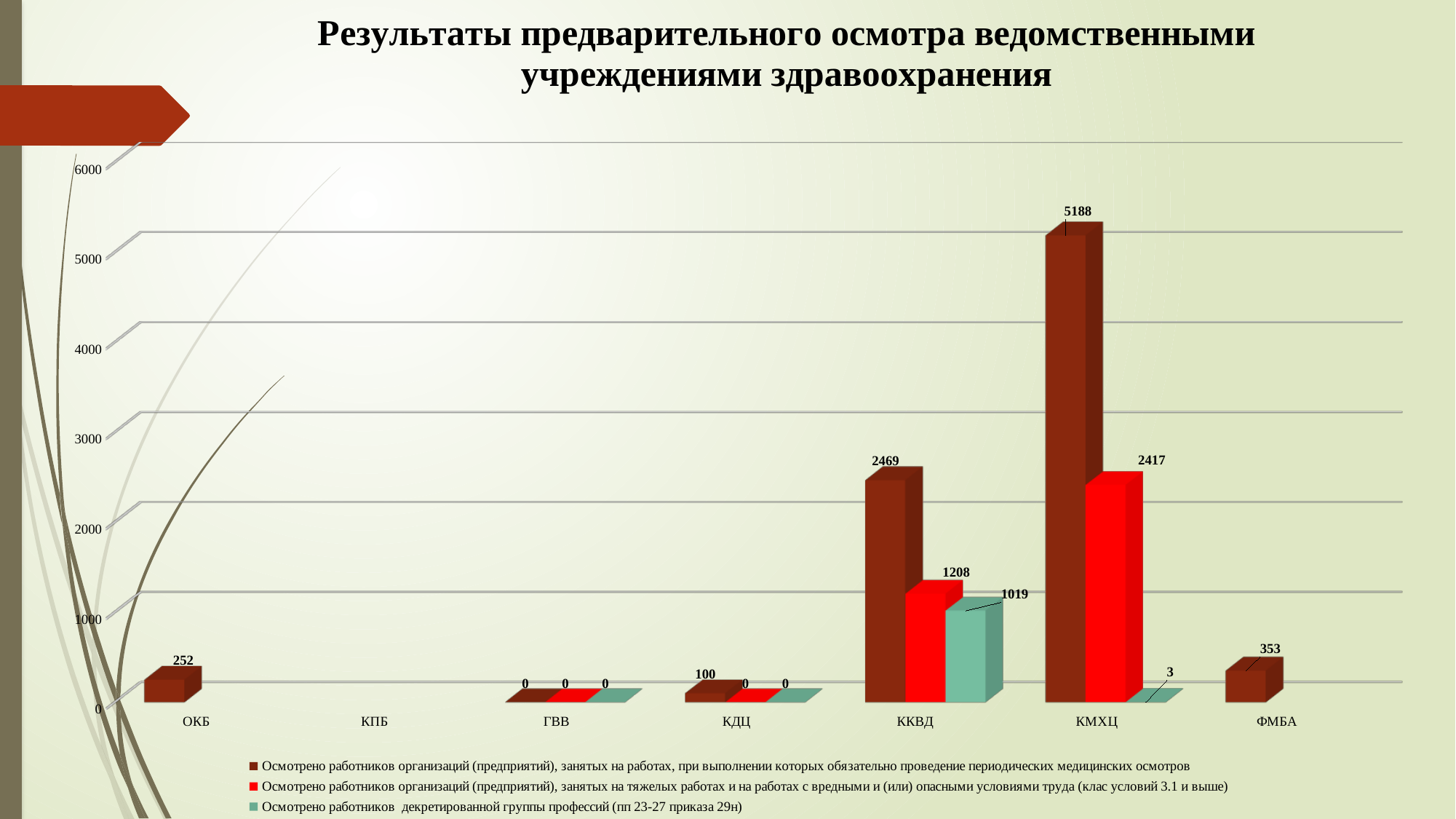
How many series does the legend list? 3 What is the value of the dark red series for ФМБА? 353 What is the value of the dark red series (workers subject to mandatory periodic medical examinations) for КМХЦ? 5188 How many categories are shown on the x axis? 7 What is the total of the three series values for ККВД? 4696 What is the value of the red series (workers in heavy and hazardous conditions, class 3.1 and above) for ККВД? 1208 Which category has the highest value in the dark red series? КМХЦ What is the difference between the dark red series values for КМХЦ and ККВД? 2719 What is the value of the teal series for КМХЦ? 3 What kind of chart is shown on the slide? bar chart What is the value of the teal series (decreed group of professions) for ККВД? 1019 Which is larger: the red series value for КМХЦ or the red series value for ККВД? КМХЦ